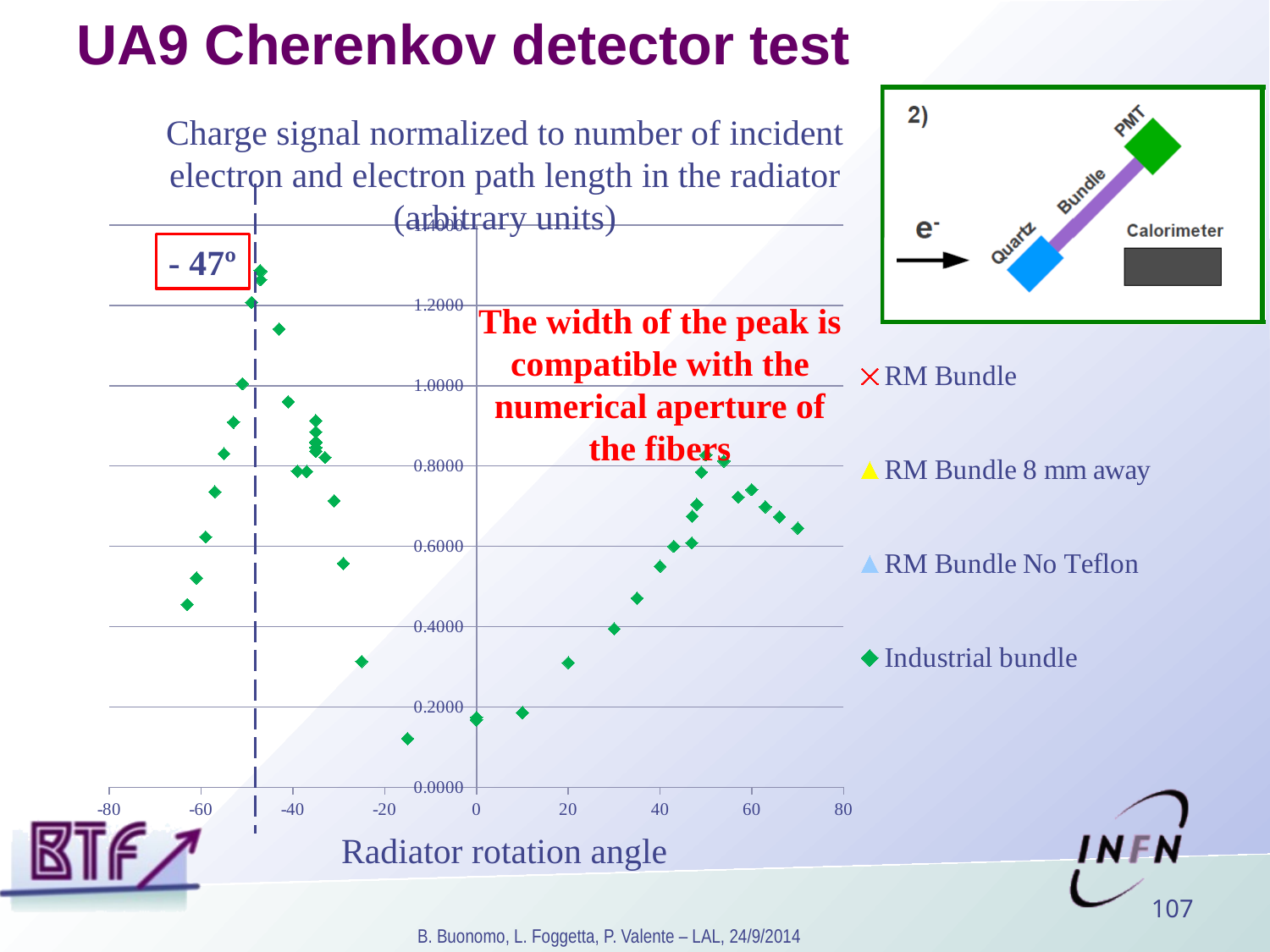
How many series does the chart legend list? 4 What kind of chart is shown on the slide? scatter chart Is the Industrial bundle value at a rotation angle of 70 greater or less than 0.6000? greater Is the Industrial bundle value at a rotation angle of 0 greater or less than 0.2000? less At which radiator rotation angle, marked by the dashed line, does the Industrial bundle signal peak? -47° Which series is plotted with green diamond markers? Industrial bundle Is the peak Industrial bundle value near -47° greater or less than 1.2000? greater Do the Industrial bundle values rise or fall as the rotation angle increases from 55 to 70? fall What is the x-axis title of the chart? Radiator rotation angle Do the Industrial bundle values rise or fall as the rotation angle increases from 0 to 50? rise